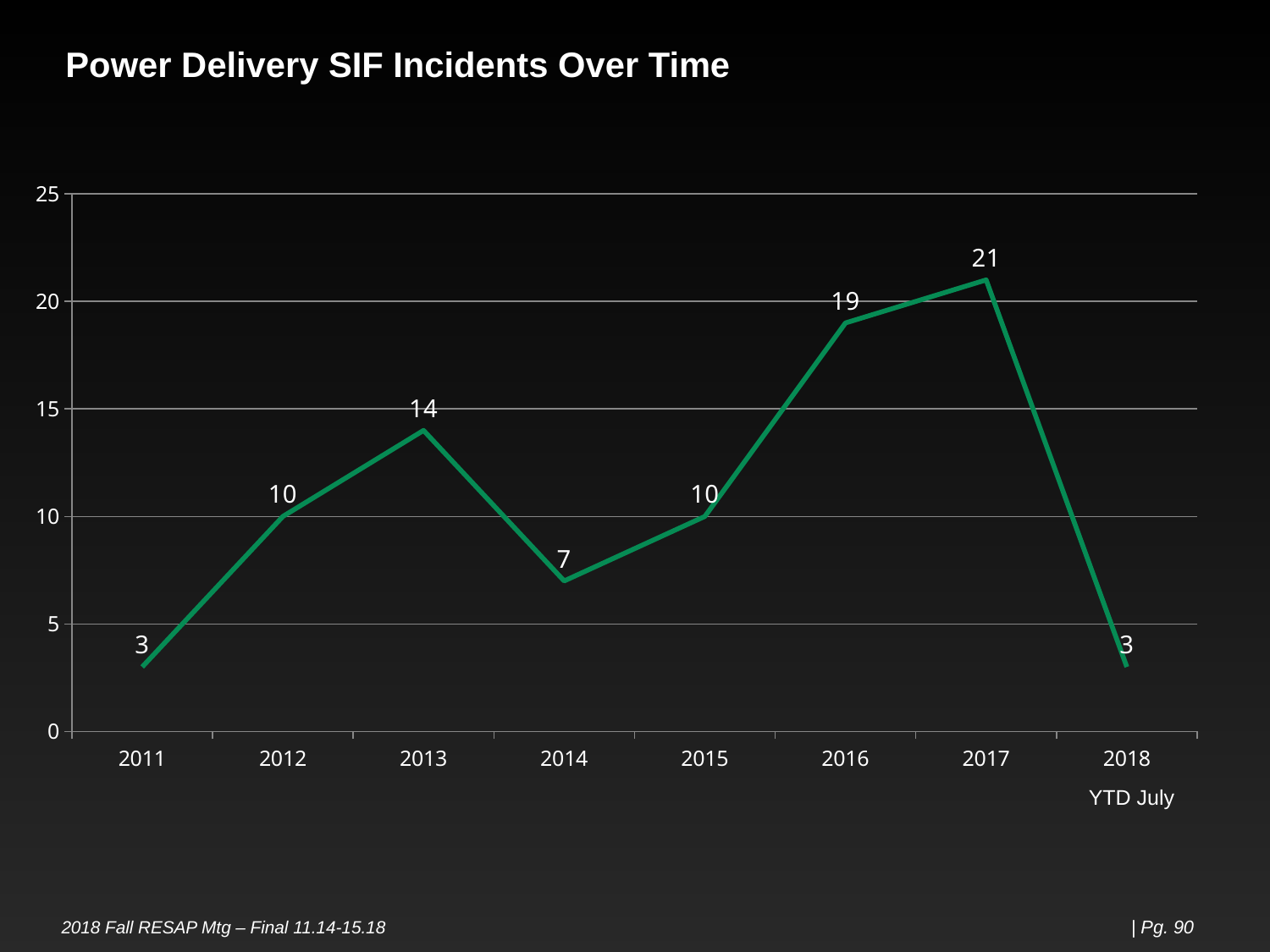
How many years are plotted on the chart? 8 What kind of chart is shown on the slide? line chart Do the values rise or fall from 2014 to 2017? rise What is the difference between the values for 2013 and 2014? 7 Is the value for 2016 greater or less than 15? greater What is the value for 2014? 7 What is the title of the chart? Power Delivery SIF Incidents Over Time Which is larger, the value for 2012 or the value for 2014? 2012 Which year has the highest value? 2017 What is the difference between the values for 2017 and 2016? 2 What is the value for 2016? 19 What is the value for 2013? 14